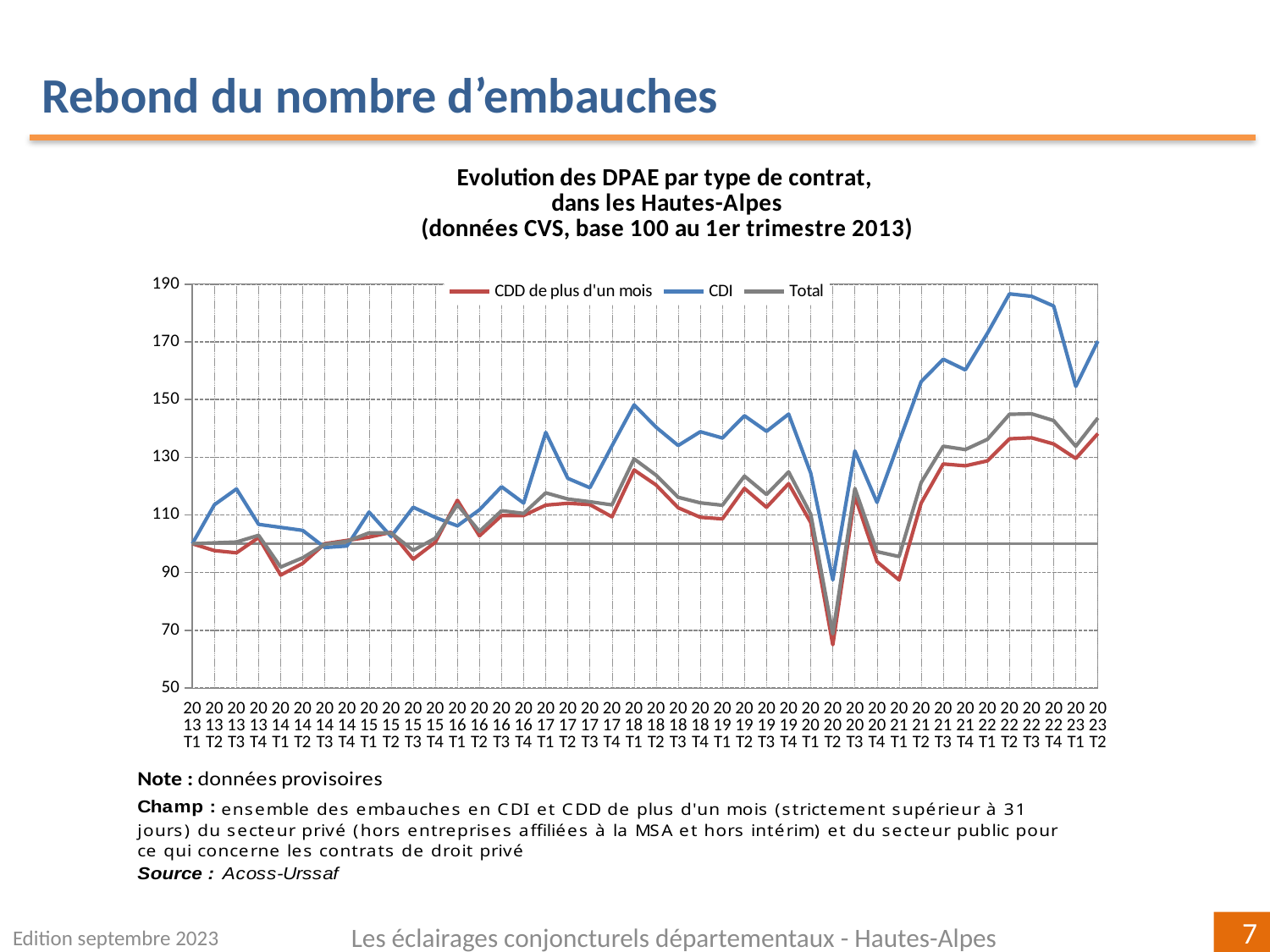
In 2022 T2, which series has the larger value, CDI or CDD de plus d'un mois? CDI In which quarter does the CDD de plus d'un mois series reach its lowest value? 2020 T2 In 2018 T1, which series has the larger value, CDI or Total? CDI Is the value for CDD de plus d'un mois in 2020 T2 greater or less than 70? less Is the value for CDI in 2023 T2 greater or less than 150? greater How many series does the legend list? 3 What kind of chart is shown on the slide? line chart Is the value for Total in 2023 T2 greater or less than 130? greater Does the CDI series rise or fall between 2022 T3 and 2023 T1? fall Which series reaches the highest value anywhere on the chart? CDI How many quarterly points are plotted along the x axis, from 2013 T1 to 2023 T2? 42